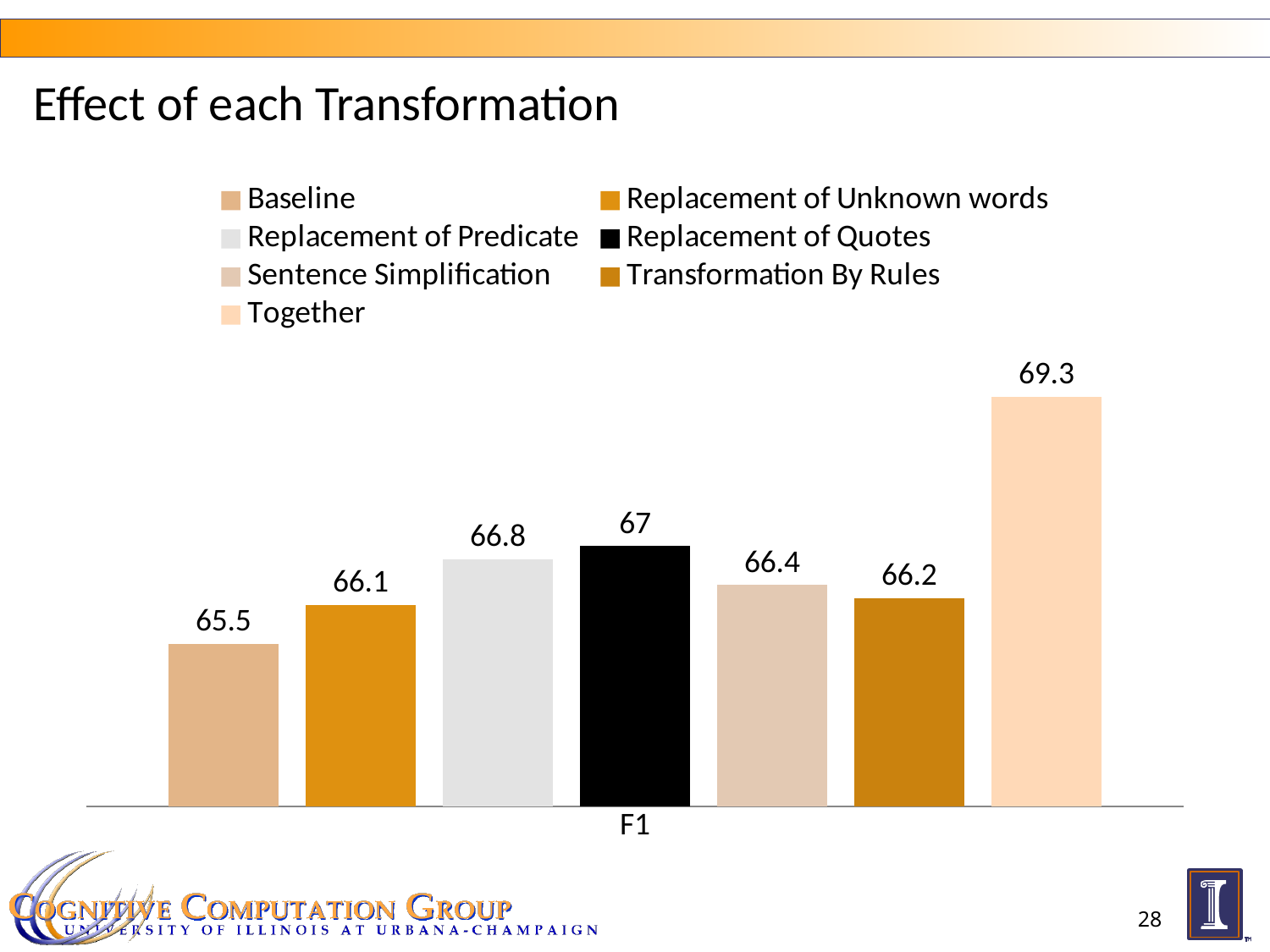
Which series has the highest F1 value? Together What is the F1 value for Replacement of Quotes? 67 Which series has the lowest F1 value? Baseline What is the difference between the F1 values for Replacement of Predicate and Replacement of Unknown words? 0.7 Which has a higher F1 value, Replacement of Quotes or Transformation By Rules? Replacement of Quotes How many series does the legend list? 7 What is the F1 value for Together? 69.3 What kind of chart is shown on the slide? Bar chart What is the difference between the F1 values for Together and Baseline? 3.8 What is the F1 value for Baseline? 65.5 What is the title of the slide containing the chart? Effect of each Transformation What is the F1 value for Sentence Simplification? 66.4